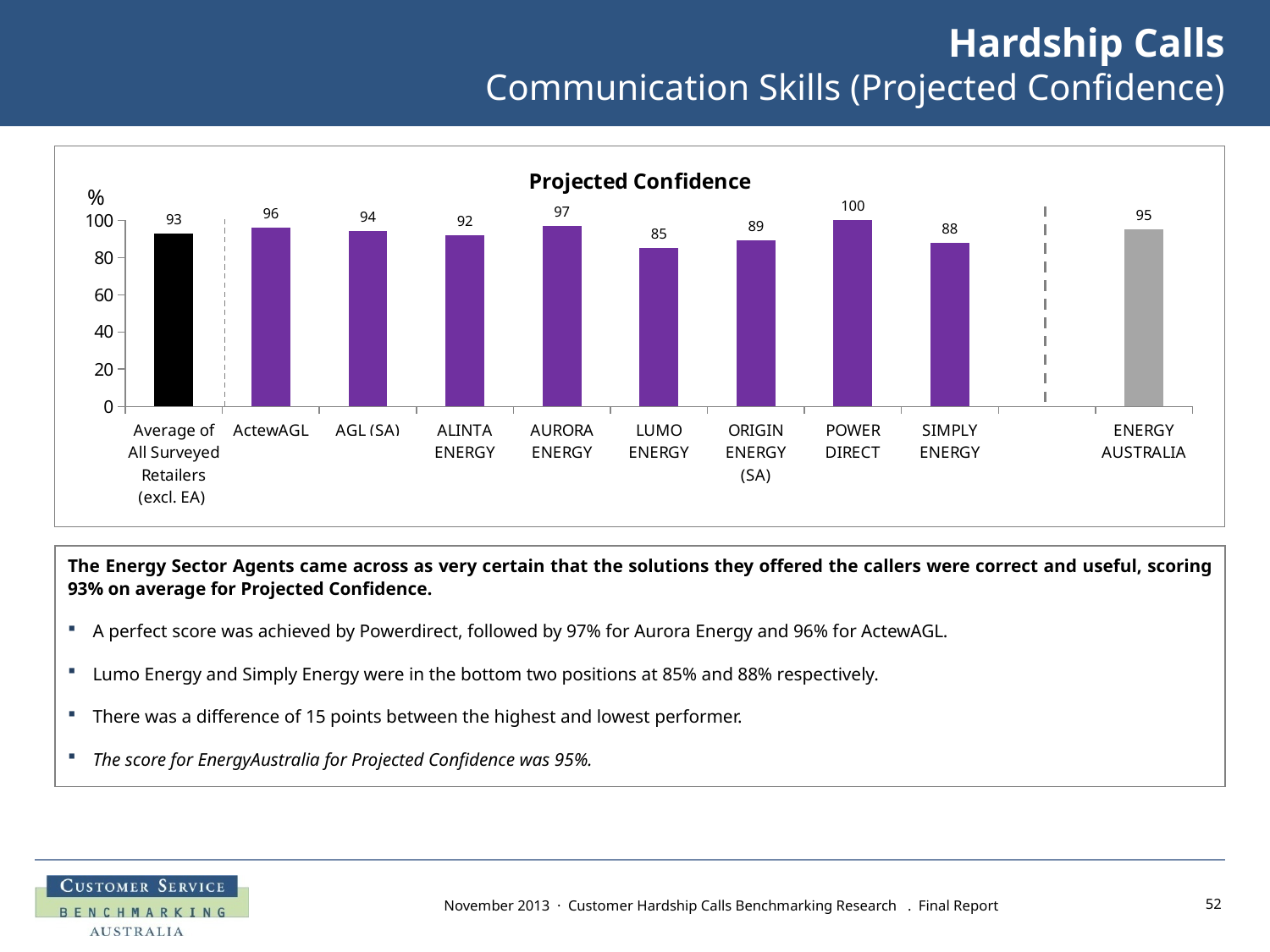
Which retailer has the lowest Projected Confidence score? LUMO ENERGY What is the Projected Confidence value for ENERGY AUSTRALIA? 95 What is the Projected Confidence value for LUMO ENERGY? 85 What is the value for the Average of All Surveyed Retailers (excl. EA)? 93 What type of chart is shown on the slide? Bar chart Which retailer has the highest Projected Confidence score? POWER DIRECT How many bars are shown in the chart? 10 What is the difference between the values for POWER DIRECT and LUMO ENERGY? 15 Which has a higher value, ActewAGL or AGL (SA)? ActewAGL What is the title of the chart? Projected Confidence What is the difference between the values for AURORA ENERGY and SIMPLY ENERGY? 9 What is the Projected Confidence value for POWER DIRECT? 100